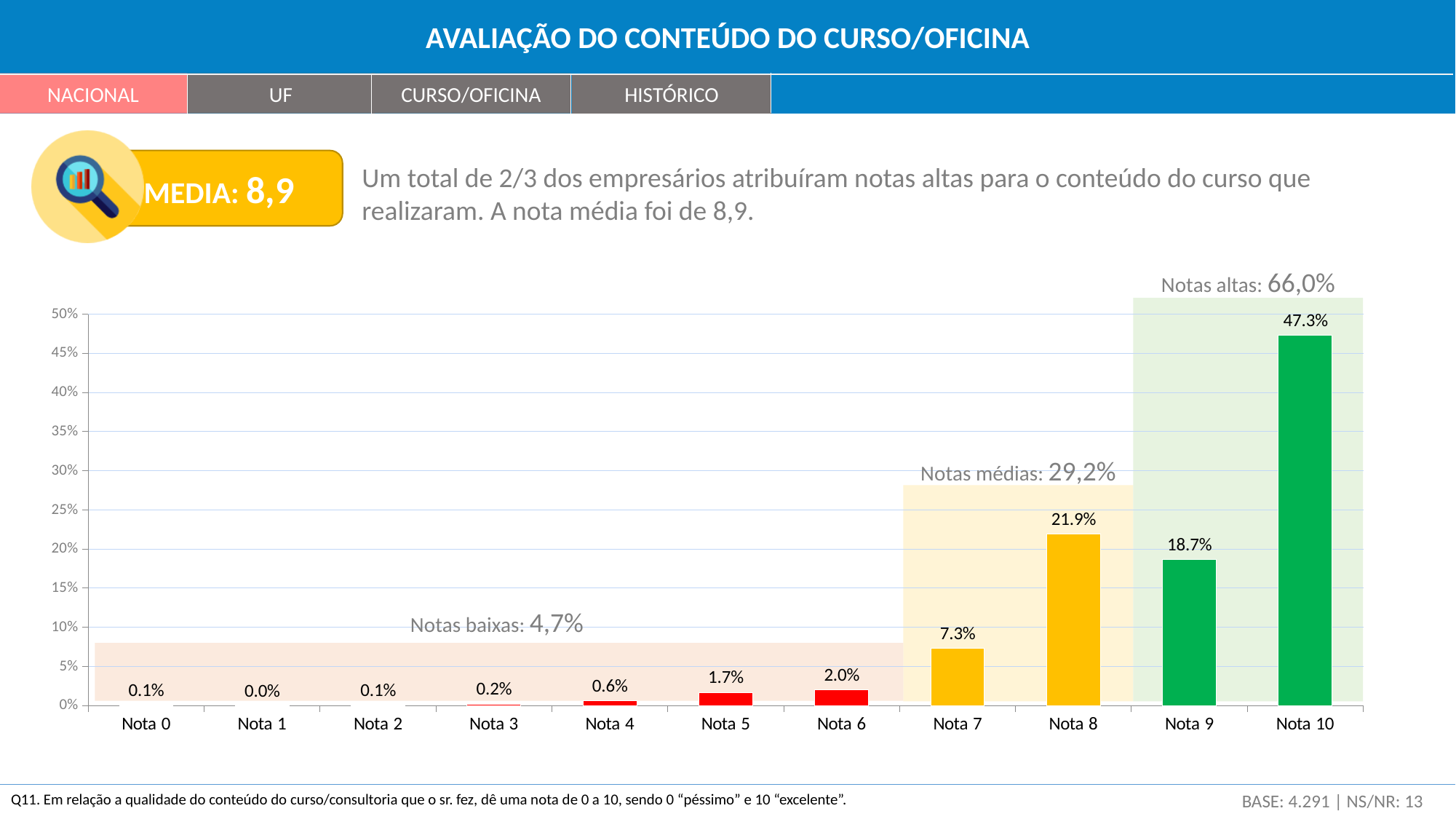
Which is larger, the value for Nota 7 or the value for Nota 8? Nota 8 Which category has the lowest value? Nota 1 What kind of chart is shown on the slide? bar chart How many categories are shown on the x axis? 11 What is the value for Nota 10? 47.3% Which category has the highest value? Nota 10 What percentage is shown for 'Notas altas' on the chart? 66,0% Do the values generally rise or fall from Nota 0 to Nota 10? rise What is the value for Nota 8? 21.9% What is the value for Nota 5? 1.7% What is the difference between the values for Nota 10 and Nota 9? 28.6% Is the value for Nota 9 greater or less than 15%? greater